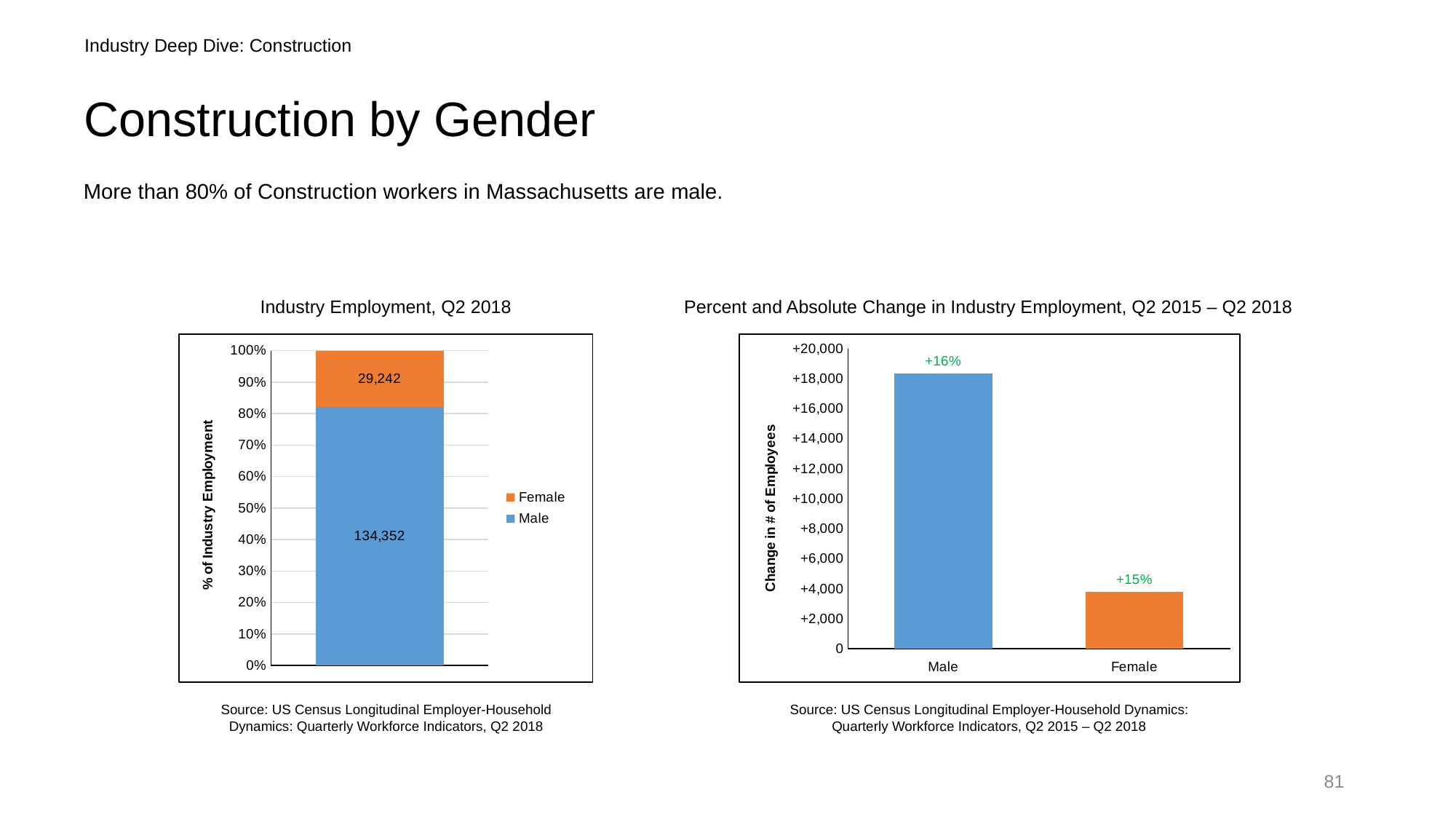
In the 'Industry Employment, Q2 2018' chart, what is the total of the stacked bar? 163,594 What kind of chart is the 'Percent and Absolute Change in Industry Employment, Q2 2015 – Q2 2018' chart? Bar chart In the 'Industry Employment, Q2 2018' chart, which colour represents Female? Orange In the 'Percent and Absolute Change in Industry Employment, Q2 2015 – Q2 2018' chart, what percent change is shown for Female? +15% In the 'Percent and Absolute Change in Industry Employment, Q2 2015 – Q2 2018' chart, which category has the highest change in number of employees? Male In the 'Industry Employment, Q2 2018' chart, how many series does the legend list? 2 In the 'Industry Employment, Q2 2018' chart, what is the difference between the Male and Female values? 105,110 In the 'Percent and Absolute Change in Industry Employment, Q2 2015 – Q2 2018' chart, is the value for Male greater or less than 16,000? greater In the 'Percent and Absolute Change in Industry Employment, Q2 2015 – Q2 2018' chart, what percent change is shown for Male? +16% In the 'Percent and Absolute Change in Industry Employment, Q2 2015 – Q2 2018' chart, is the value for Female greater or less than 6,000? less In the 'Industry Employment, Q2 2018' chart, what is the value for Female? 29,242 In the 'Industry Employment, Q2 2018' chart, what is the value for Male? 134,352